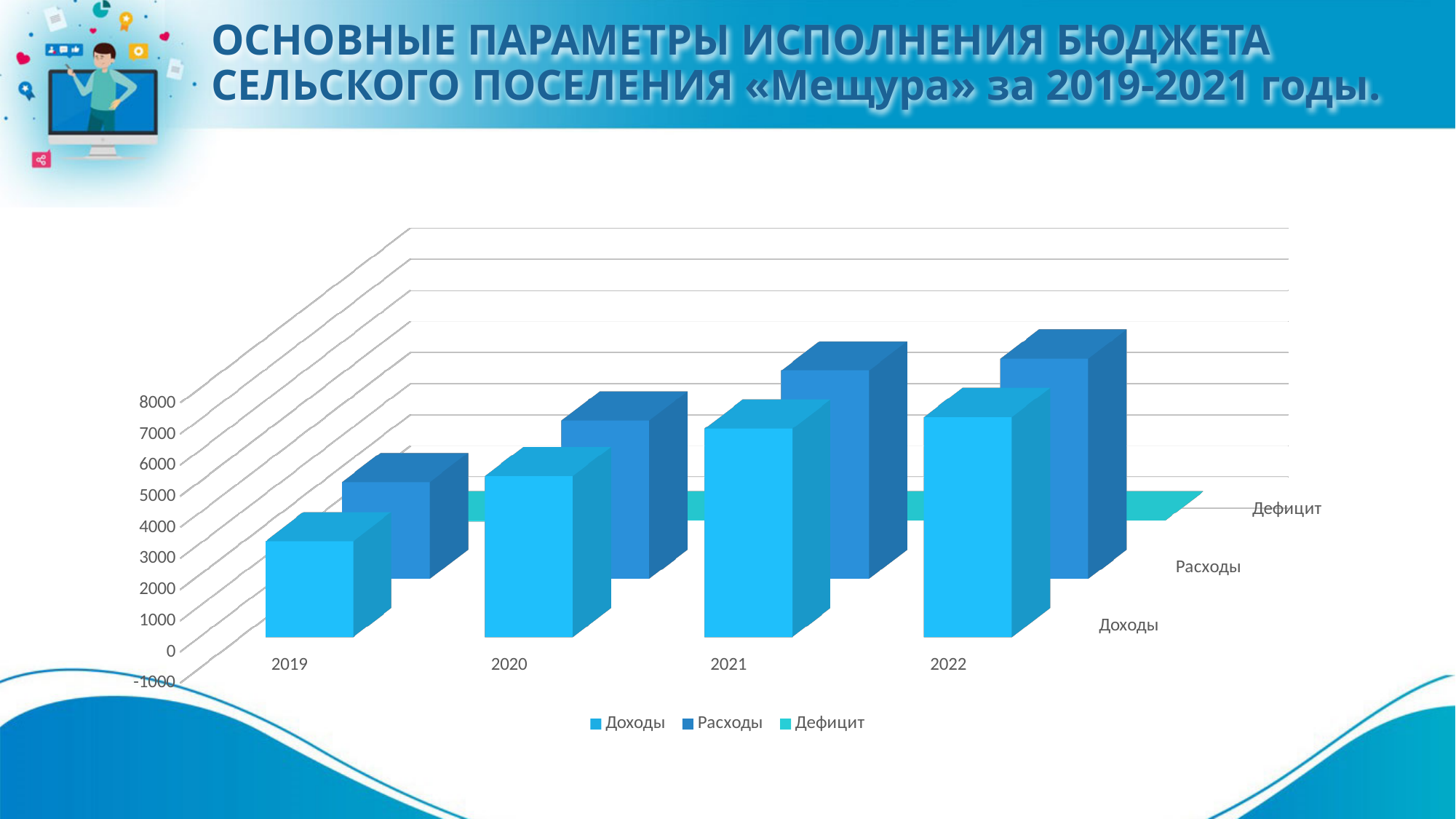
Which is larger for Доходы: 2019 or 2021? 2021 Is the value for Расходы in 2022 greater or less than 5000? greater Which year has the highest value for Расходы? 2022 How many series does the chart legend list? 3 How many years are shown on the x axis of the chart? 4 Do the values for Расходы rise or fall from 2019 to 2022? rise What are the three series named in the chart legend? Доходы, Расходы, Дефицит Which year has the lowest value for Доходы? 2019 What kind of chart is shown on the slide? bar chart Is the value for Доходы in 2019 greater or less than 5000? less Do the values for Доходы rise or fall from 2019 to 2022? rise